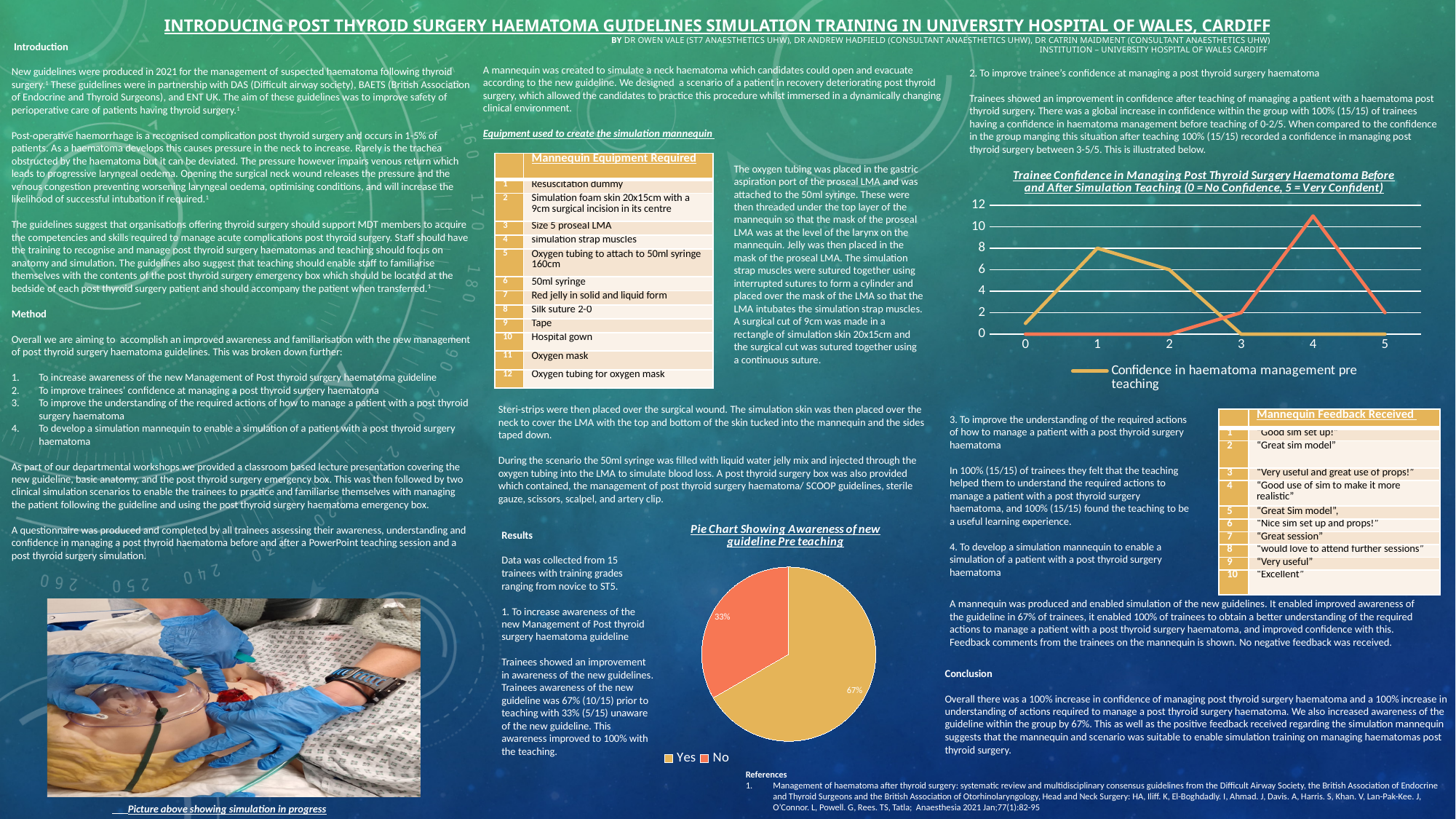
In the pie chart showing awareness of the new guideline pre teaching, what colour is the Yes slice? Yellow In the trainee confidence line chart, is the value of the pre-teaching series at confidence level 5 greater or less than 2? less In the pie chart showing awareness of the new guideline pre teaching, what share of trainees answered No? 33% How many entries does the legend of the pie chart showing awareness of the new guideline pre teaching list? 2 In the trainee confidence line chart, what is the highest value shown on the y axis? 12 In the trainee confidence line chart, how many confidence levels are shown along the x axis? 6 In the trainee confidence line chart, is the value of the pre-teaching series at confidence level 1 greater or less than 4? greater In the pie chart showing awareness of the new guideline pre teaching, what share of trainees answered Yes? 67% In the pie chart showing awareness of the new guideline pre teaching, which slice is larger, Yes or No? Yes In the pie chart showing awareness of the new guideline pre teaching, what is the difference in percentage points between the Yes and No slices? 34 percentage points What kind of chart is the chart titled 'Pie Chart Showing Awareness of new guideline Pre teaching'? Pie chart What kind of chart is the chart titled 'Trainee Confidence in Managing Post Thyroid Surgery Haematoma Before and After Simulation Teaching'? Line chart